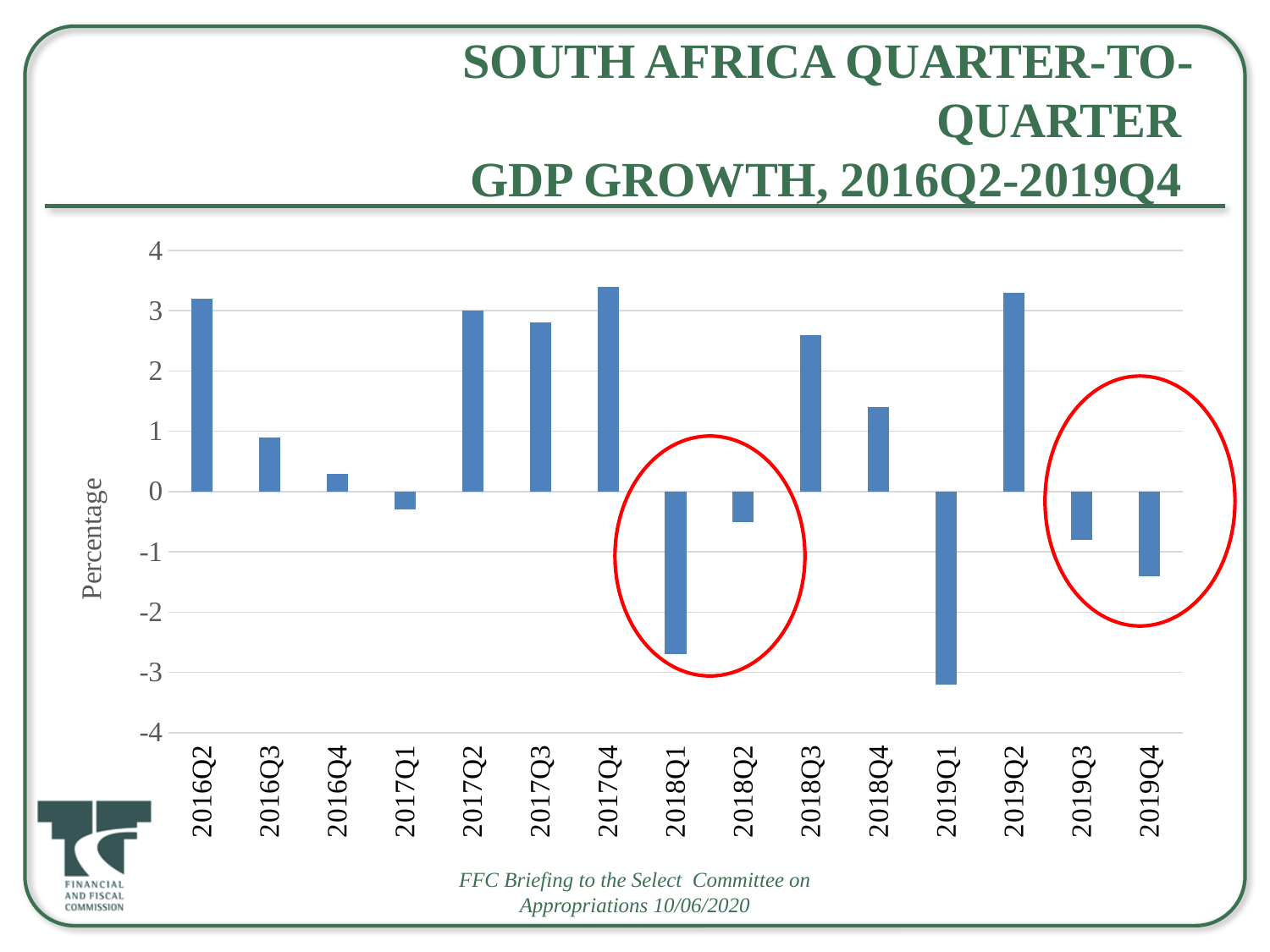
What is the label on the y axis? Percentage How many quarters are plotted on the x axis? 15 Is the value for 2019Q4 greater or less than -1? less Is the value for 2018Q1 greater or less than -2? less Is the value for 2018Q4 greater or less than 1? greater Do the values rise or fall from 2016Q2 to 2017Q1? fall Which quarter has the lowest GDP growth value? 2019Q1 What kind of chart is shown on the slide? Bar chart Which is larger, the value for 2018Q3 or the value for 2018Q4? 2018Q3 Which is larger, the value for 2016Q2 or the value for 2016Q3? 2016Q2